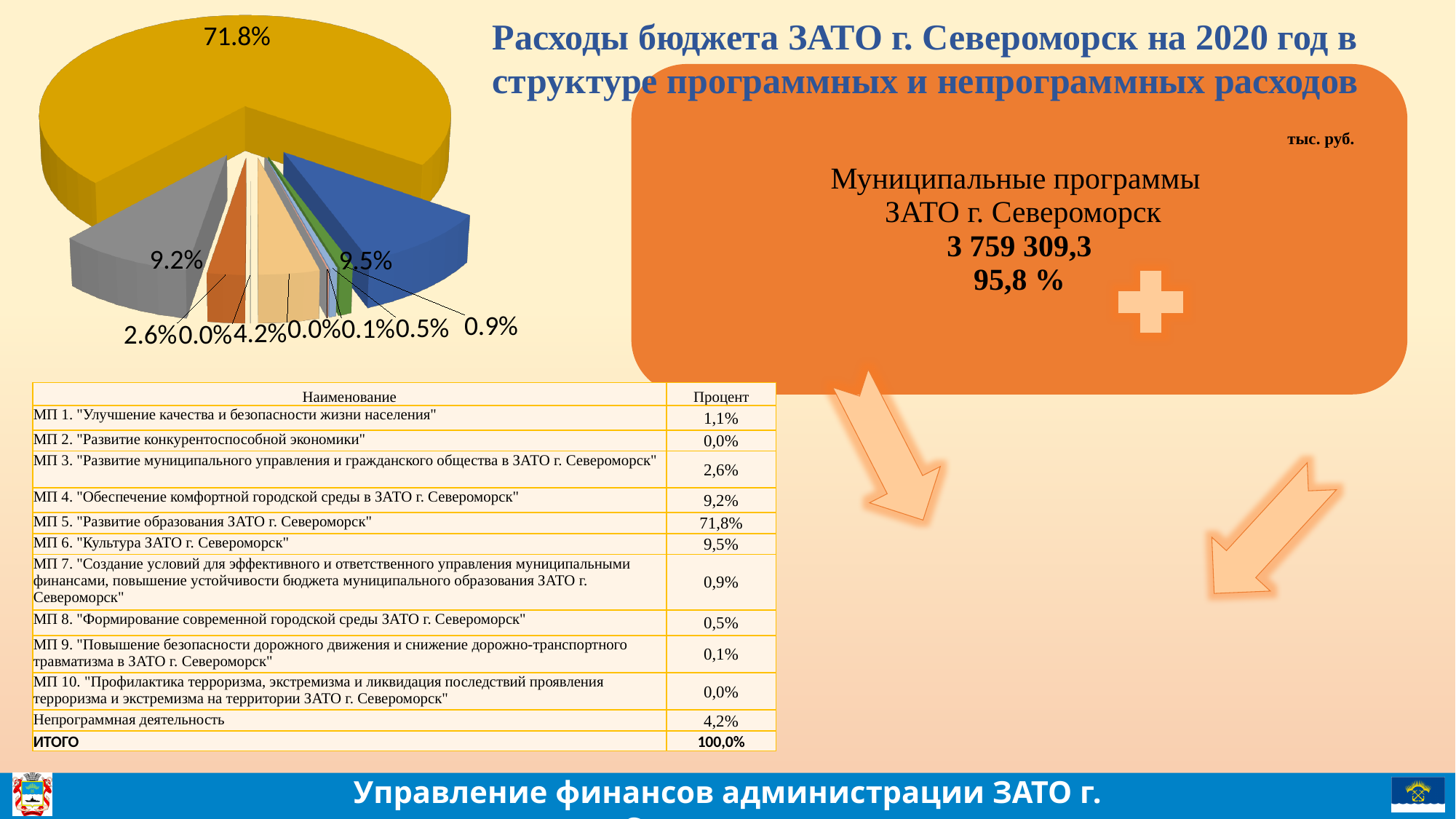
Does the pie chart have a legend? No What percentage is labelled on the large yellow slice of the pie chart? 71.8% According to the table on the slide, which programme corresponds to the 71.8% slice of the pie chart? МП 5. "Развитие образования ЗАТО г. Североморск" Which slice of the pie chart is larger, the blue one (9.5%) or the grey one (9.2%)? the blue one (9.5%) What is the difference in percentage points between the 9.5% slice and the 9.2% slice of the pie chart? 0.3 What percentage is labelled on the grey slice of the pie chart? 9.2% By how many percentage points does the 71.8% slice exceed the 9.5% slice in the pie chart? 62.3 What is the combined share of the three largest slices of the pie chart (71.8%, 9.5% and 9.2%)? 90.5% What percentage is labelled on the blue slice of the pie chart? 9.5% What kind of chart is shown on the left of the slide? pie chart How many slices of the pie chart are labelled 0.0%? 2 What is the largest percentage labelled on the pie chart? 71.8%